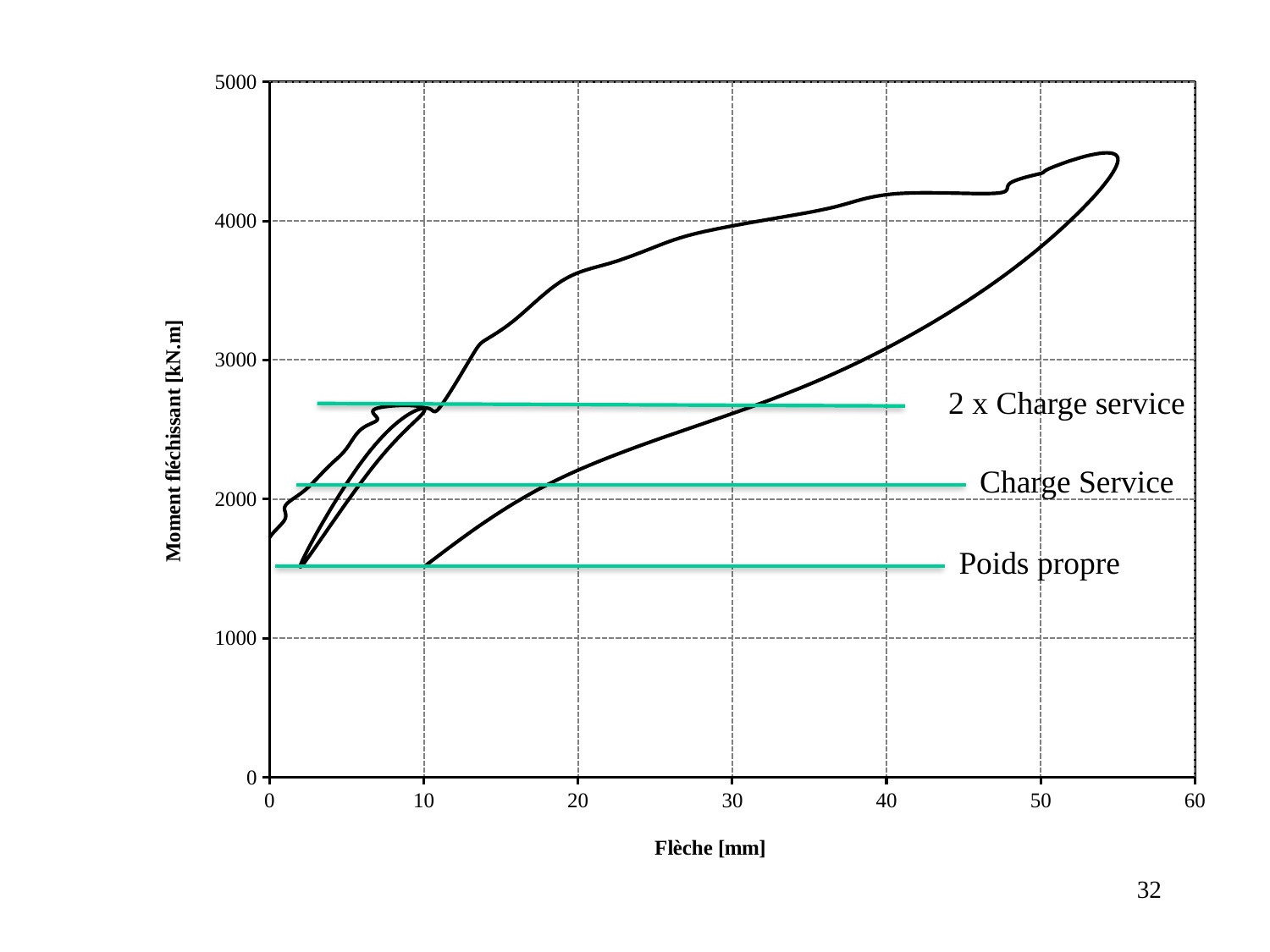
Which horizontal reference line is at the lowest moment level: 'Poids propre', 'Charge Service' or '2 x Charge service'? Poids propre Is the moment level of the horizontal line labelled 'Poids propre' greater or less than 2000 kN.m? less Is the moment level of the horizontal line labelled 'Poids propre' greater or less than 1000 kN.m? greater What is the label of the y axis? Moment fléchissant [kN.m] Which horizontal reference line is at the highest moment level: 'Poids propre', 'Charge Service' or '2 x Charge service'? 2 x Charge service Is the maximum moment reached by the curve greater or less than 4000 kN.m? greater What kind of chart is shown on the slide? line chart What is the label of the x axis? Flèche [mm]